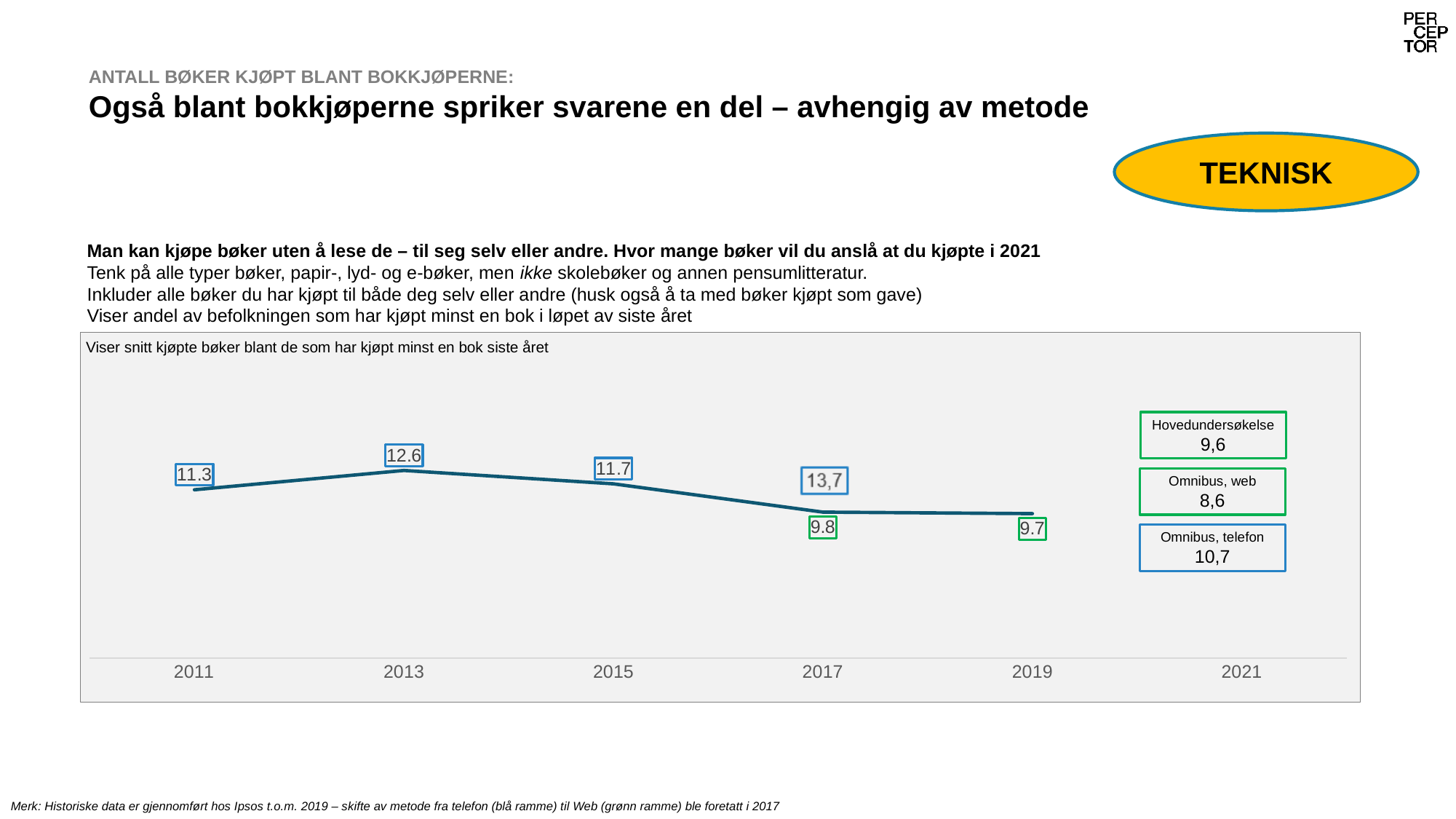
What type of chart is shown on the slide? line chart Which is larger in 2021: 'Omnibus, telefon' or 'Omnibus, web'? Omnibus, telefon Which year has the highest value on the plotted line? 2013 What is the value shown for 'Omnibus, telefon' in 2021? 10,7 What is the value shown for 'Hovedundersøkelse' in 2021? 9,6 What is the green-framed value shown for 2019? 9.7 What is the value shown for 2013? 12.6 What is the blue-framed value shown for 2017? 13,7 What is the value shown for 2011? 11.3 What is the difference between the 2013 value (12.6) and the 2011 value (11.3)? 1.3 What is the value shown for 2015? 11.7 What is the value shown for 'Omnibus, web' in 2021? 8,6